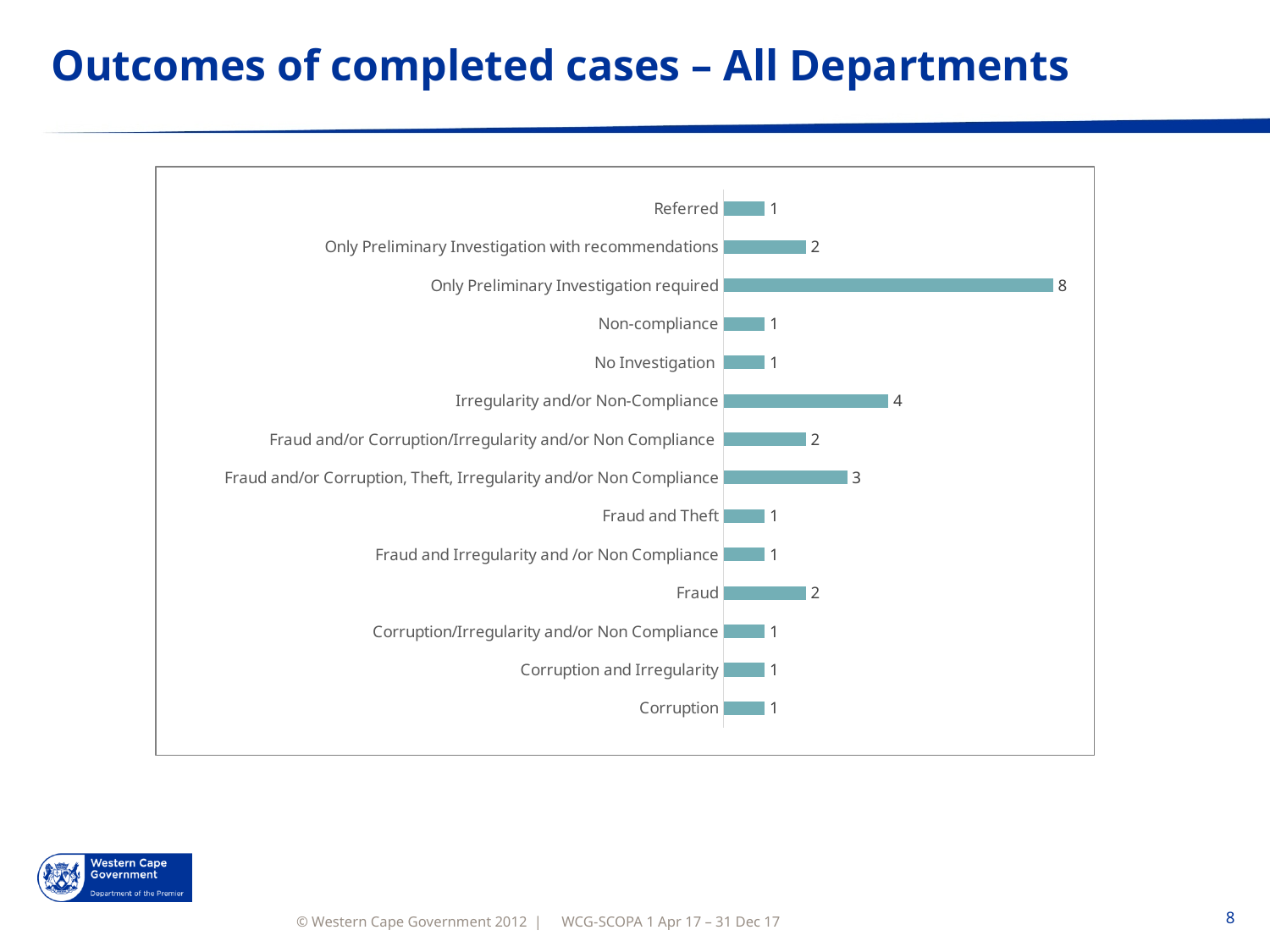
What is the value for "Fraud and/or Corruption, Theft, Irregularity and/or Non Compliance"? 3 What is the value for "Only Preliminary Investigation required"? 8 What is the difference between the values for "Only Preliminary Investigation required" and "Irregularity and/or Non-Compliance"? 4 What type of chart is shown on the slide? bar chart What is the value for "Fraud"? 2 Which is larger, the value for "Irregularity and/or Non-Compliance" or the value for "Only Preliminary Investigation with recommendations"? Irregularity and/or Non-Compliance How many categories are shown in the chart? 14 Which category has the highest value? Only Preliminary Investigation required What is the value for "Irregularity and/or Non-Compliance"? 4 What is the value for "Referred"? 1 What is the title of the slide? Outcomes of completed cases – All Departments What is the difference between the values for "Fraud and/or Corruption, Theft, Irregularity and/or Non Compliance" and "Fraud"? 1